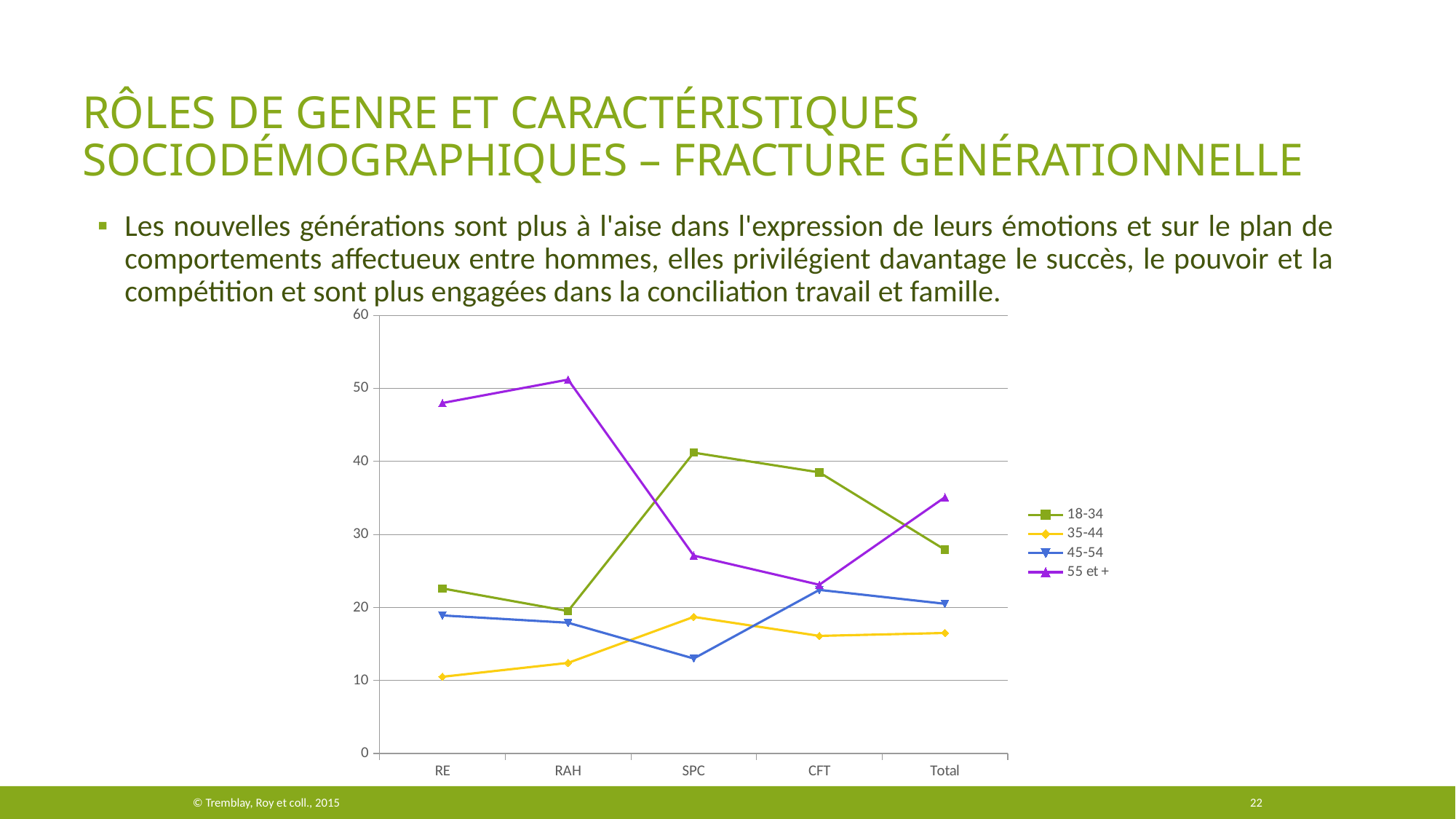
How many series does the chart's legend list? 4 At RE, which series has the larger value, 55 et + or 18-34? 55 et + What kind of chart is shown on the slide? line chart Which category has the highest value for the 55 et + series? RAH Which series is drawn in purple in the chart? 55 et + Which category has the highest value for the 18-34 series? SPC Is the value for the 35-44 series at RE greater or less than 20? less Is the value for the 55 et + series at RAH greater or less than 50? greater How many categories are shown on the x axis of the chart? 5 At SPC, which series has the larger value, 18-34 or 55 et +? 18-34 Which category has the lowest value for the 35-44 series? RE Which category has the lowest value for the 45-54 series? SPC